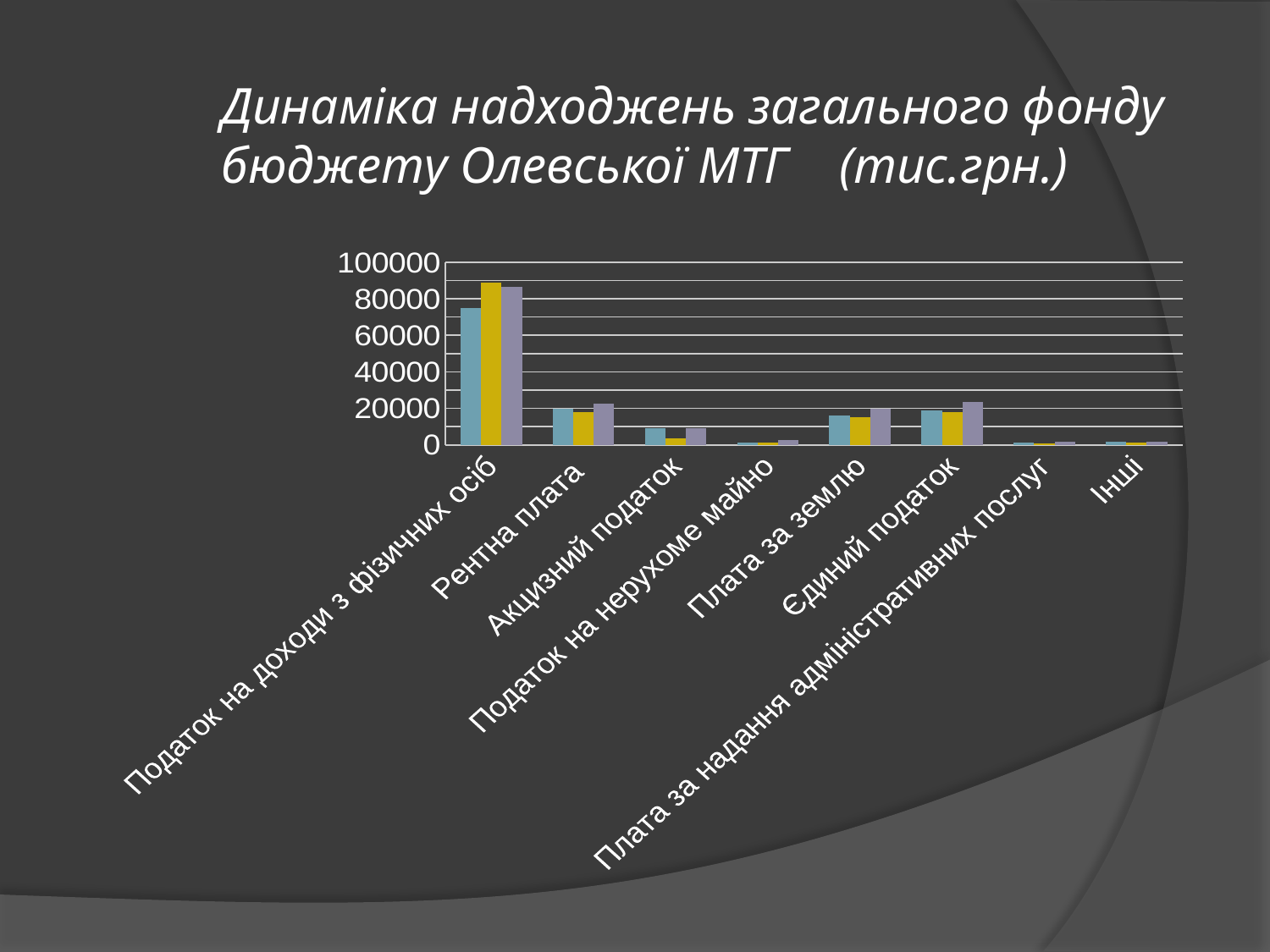
Are the values for Плата за землю greater or less than 40000? less Are the values for Податок на доходи з фізичних осіб greater or less than 60000? greater Are the values for Рентна плата greater or less than 40000? less Which category has the highest bars in the chart? Податок на доходи з фізичних осіб Which category has larger values, Рентна плата or Акцизний податок? Рентна плата How many categories are shown on the x axis of the chart? 8 What is the maximum value shown on the vertical axis of the chart? 100000 What kind of chart is shown on the slide? bar chart How many bars are plotted for each category in the chart? 3 In what units are the values in the chart expressed, according to the slide title? тис.грн. Which category has larger values, Податок на доходи з фізичних осіб or Рентна плата? Податок на доходи з фізичних осіб